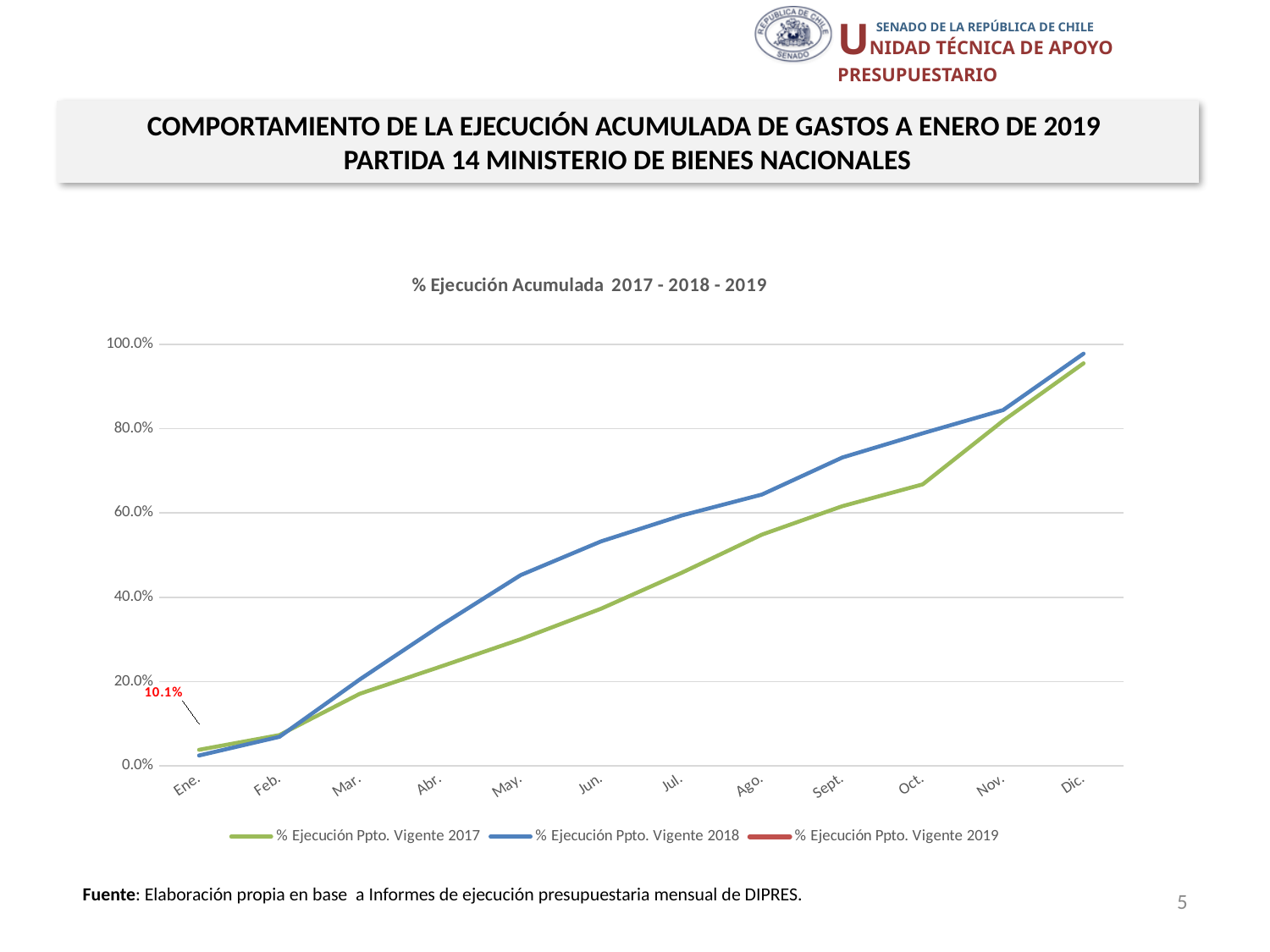
How many months are shown along the x axis? 12 What is the value labelled for % Ejecución Ppto. Vigente 2019 in Ene.? 10.1% In which month does % Ejecución Ppto. Vigente 2017 reach its highest value? Dic. Is the value for % Ejecución Ppto. Vigente 2017 in May. greater or less than 40.0%? less Is the value for % Ejecución Ppto. Vigente 2018 in May. greater or less than 40.0%? greater What is the title of the chart? % Ejecución Acumulada 2017 - 2018 - 2019 Is the value for % Ejecución Ppto. Vigente 2017 in Oct. greater or less than 60.0%? greater In Jun., which series has the larger value, % Ejecución Ppto. Vigente 2017 or % Ejecución Ppto. Vigente 2018? % Ejecución Ppto. Vigente 2018 Do the values for % Ejecución Ppto. Vigente 2018 rise or fall from Ene. to Dic.? Rise What kind of chart is shown on the slide? Line chart How many series does the legend list? 3